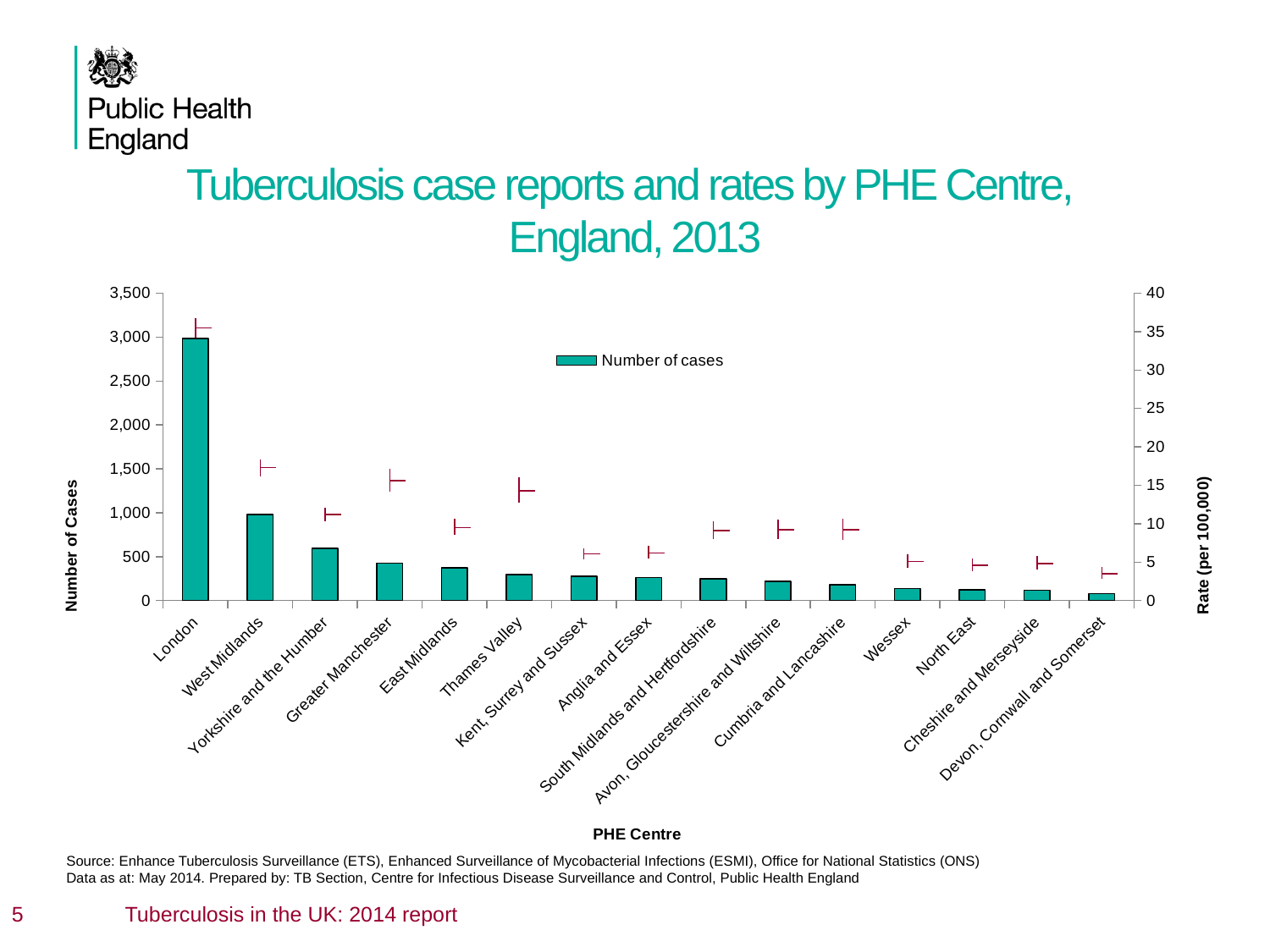
Which PHE Centre has the highest number of cases? London How many series does the legend list? 1 Is the number of cases for Greater Manchester greater or less than 500? less Do the number of cases rise or fall moving from left to right along the x axis? fall Is the number of cases for Thames Valley greater or less than 500? less Which PHE Centre has the lowest number of cases? Devon, Cornwall and Somerset Which has more cases, Yorkshire and the Humber or Greater Manchester? Yorkshire and the Humber What kind of chart is shown on the slide? bar chart Is the number of cases for Yorkshire and the Humber greater or less than 500? greater Which has more cases, London or West Midlands? London How many PHE Centres are shown on the x axis? 15